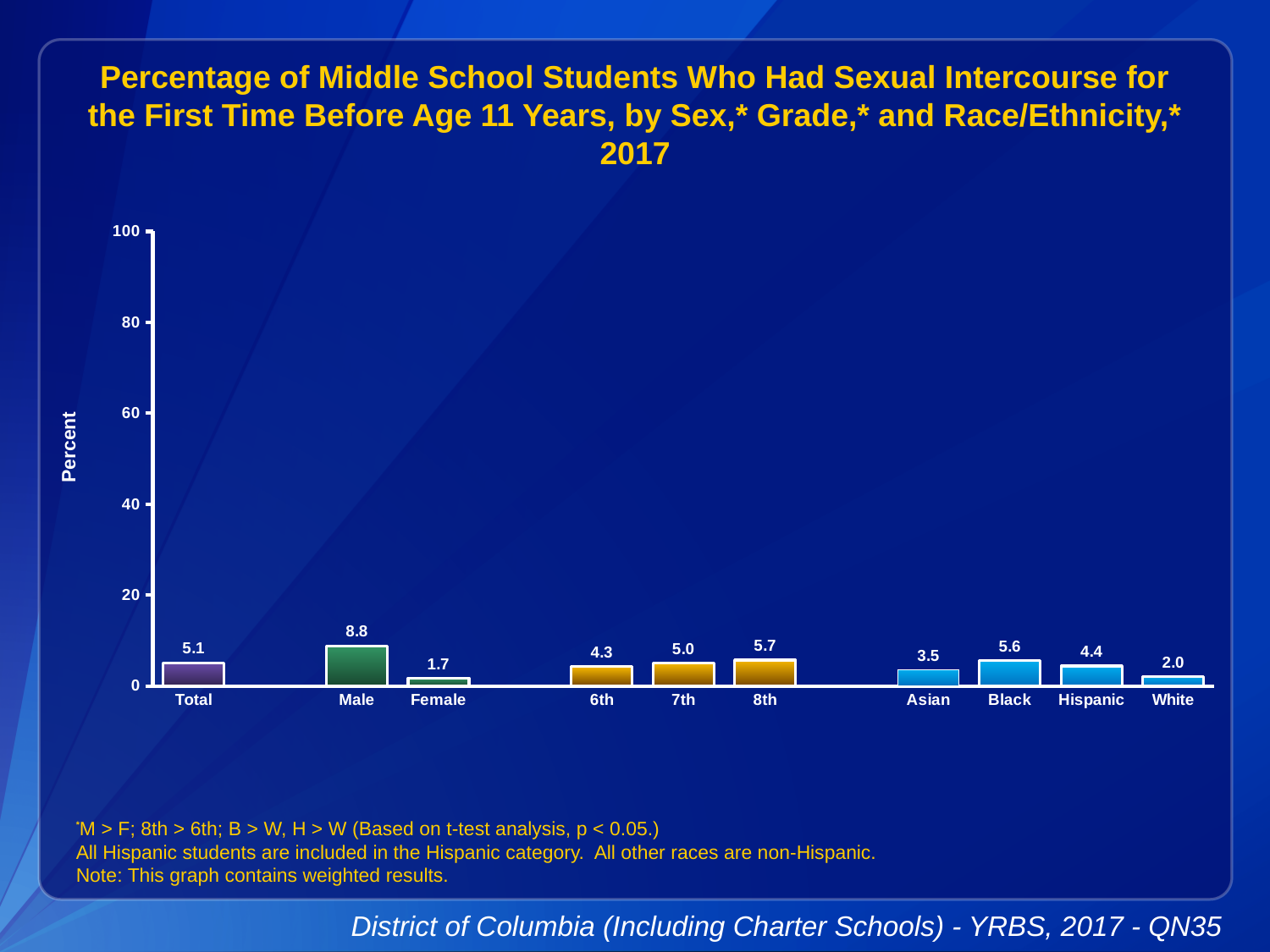
How many categories are shown on the x axis? 10 What is the value for Male? 8.8 Is the value for Male greater or less than 20? less Which category has the lowest value? Female Which category has the highest value? Male What is the value for Hispanic? 4.4 What kind of chart is this? bar chart Which is larger, the value for Black or the value for White? Black What is the value for Total? 5.1 What is the value for Female? 1.7 What is the difference between the values for 8th and 6th? 1.4 What is the difference between the values for Male and Female? 7.1